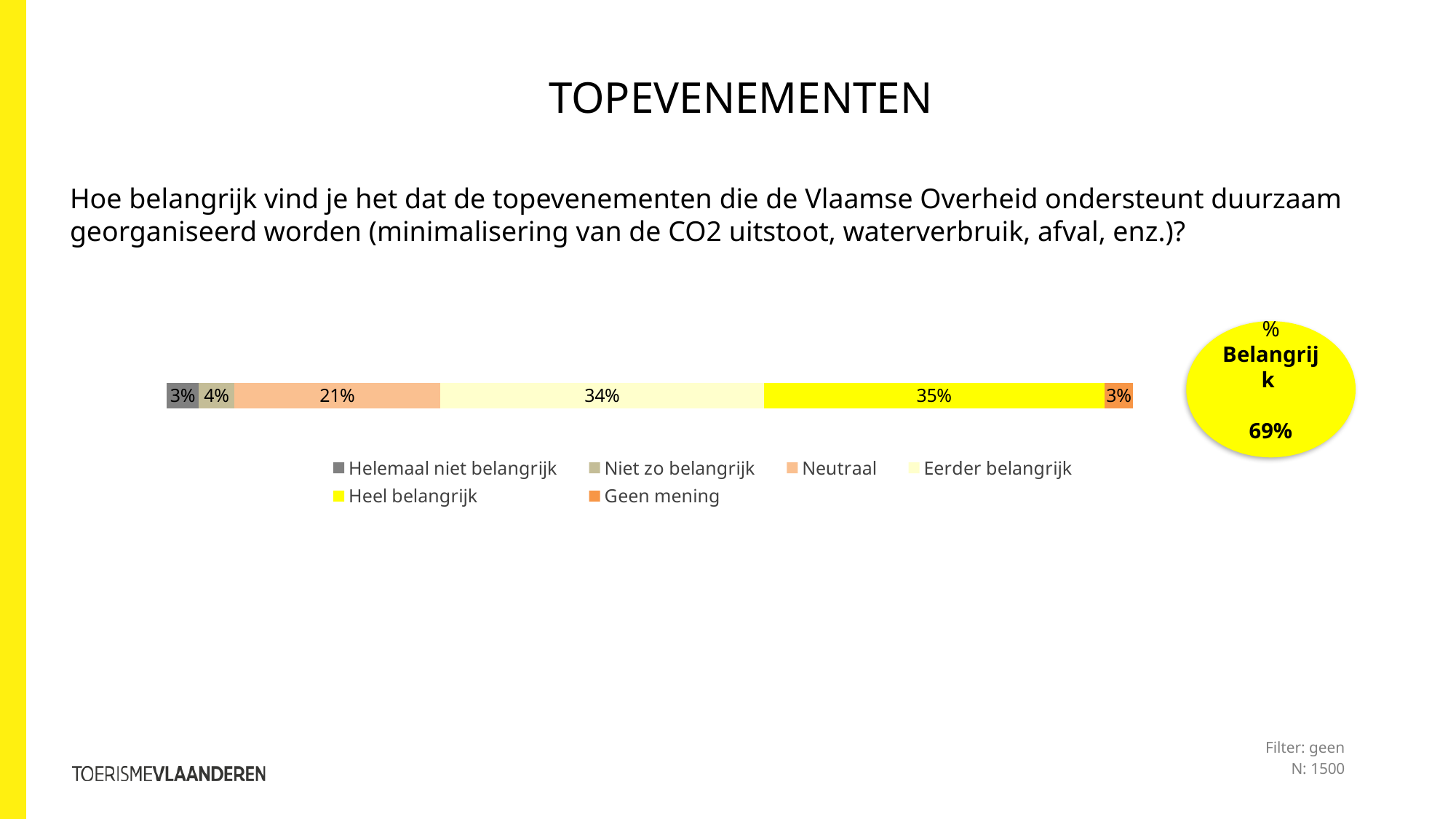
How many answer categories does the legend list? 6 What percentage of respondents answered 'Heel belangrijk'? 35% What percentage of respondents answered 'Niet zo belangrijk'? 4% What percentage is shown in the yellow '% Belangrijk' circle next to the chart? 69% What is the total of all segments in the stacked bar? 100% What percentage of respondents answered 'Neutraal'? 21% What percentage of respondents answered 'Geen mening'? 3% Which is larger, the share for 'Eerder belangrijk' or the share for 'Neutraal'? Eerder belangrijk Which answer category has the largest share in the bar? Heel belangrijk What is the difference between the 'Heel belangrijk' and 'Neutraal' shares? 14% What percentage of respondents answered 'Eerder belangrijk'? 34% What kind of chart is shown on the slide? Stacked bar chart